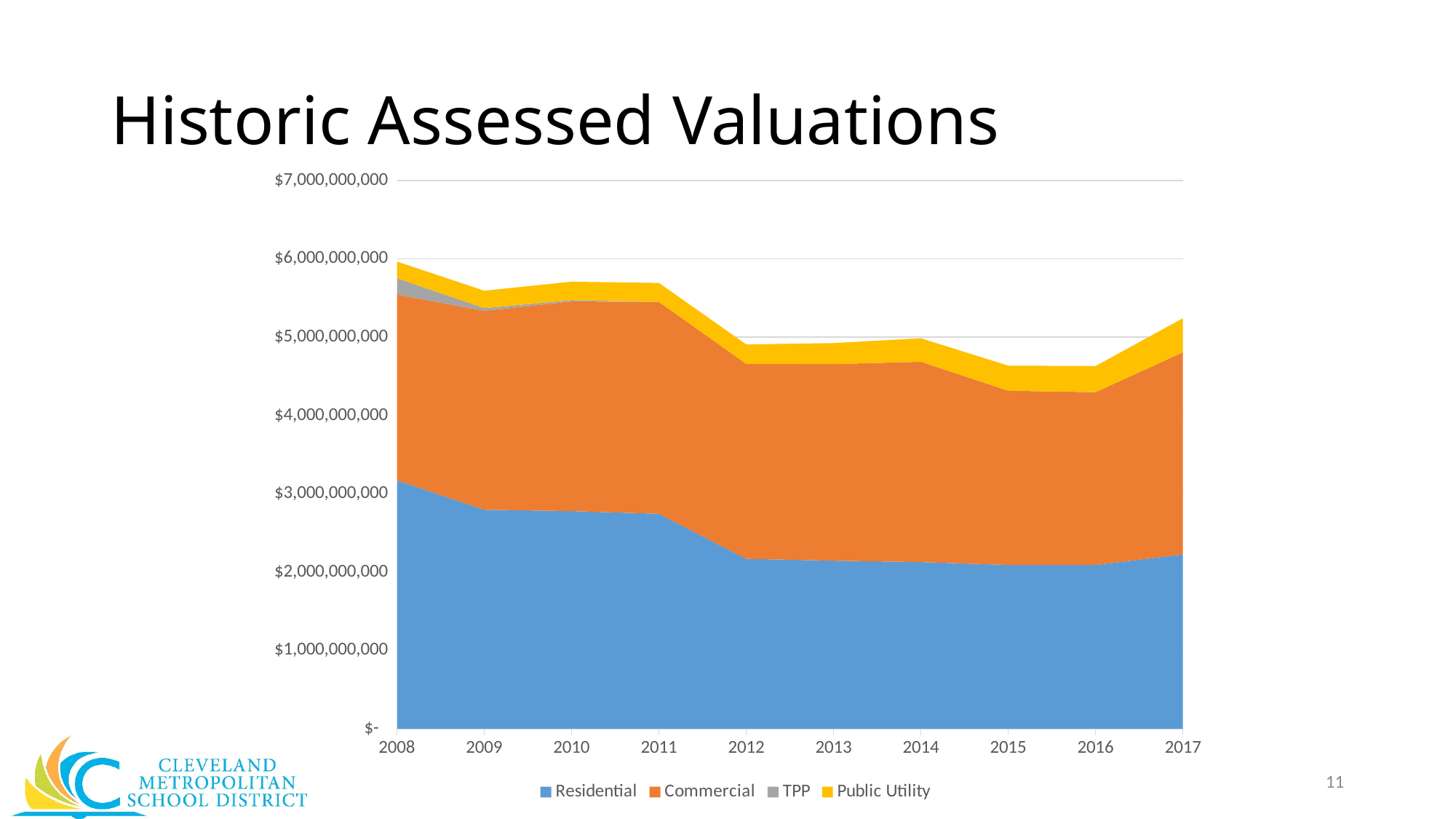
Is the total assessed valuation for 2016 greater or less than $5,000,000,000? less Which year has the larger total assessed valuation, 2011 or 2012? 2011 How many series does the legend list? 4 Which series is shown in blue in the legend? Residential How many years are shown along the x axis? 10 Is the total assessed valuation for 2017 greater or less than $5,000,000,000? greater Is the Residential value for 2008 greater or less than $3,000,000,000? greater What is the title of the chart? Historic Assessed Valuations In which year is the total assessed valuation highest? 2008 What kind of chart is shown on the slide? stacked area chart Does the Residential value rise or fall from 2008 to 2016? fall